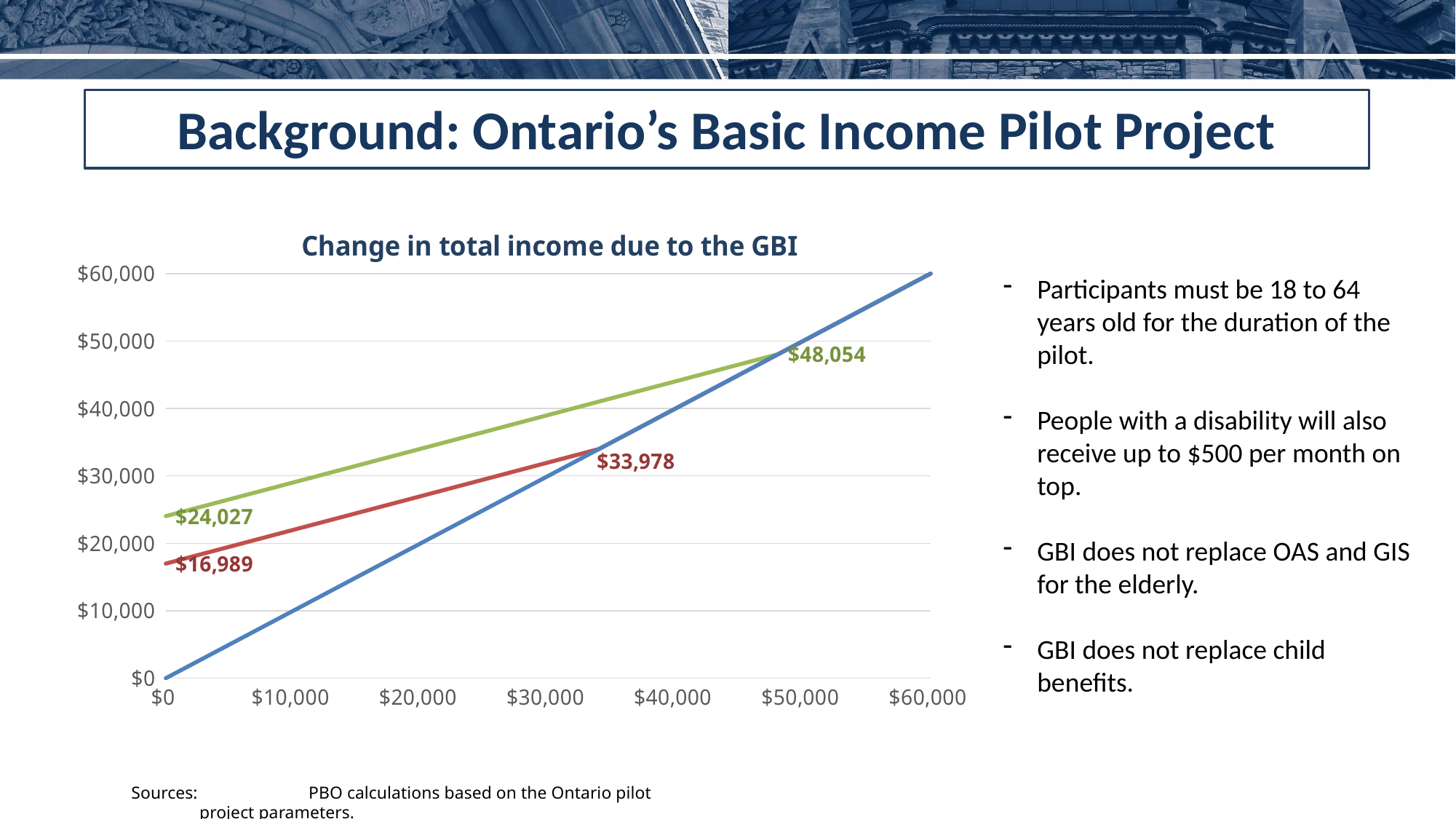
At $0 on the x axis, which line has the higher value, the green line or the red line? Green line Do the lines rise or fall as the x-axis value increases? Rise What is the labelled starting value of the red line at $0 on the x axis? $16,989 What is the labelled value at the end of the green line? $48,054 What is the labelled starting value of the green line at $0 on the x axis? $24,027 What is the difference between the end value of the green line ($48,054) and its starting value ($24,027)? $24,027 What is the difference between the end value of the red line ($33,978) and its starting value ($16,989)? $16,989 How many lines are plotted on the chart? 3 What type of chart is shown on the slide? Line chart How much higher is the green line's starting value than the red line's starting value? $7,038 What is the title of the chart? Change in total income due to the GBI What is the labelled value at the end of the red line? $33,978